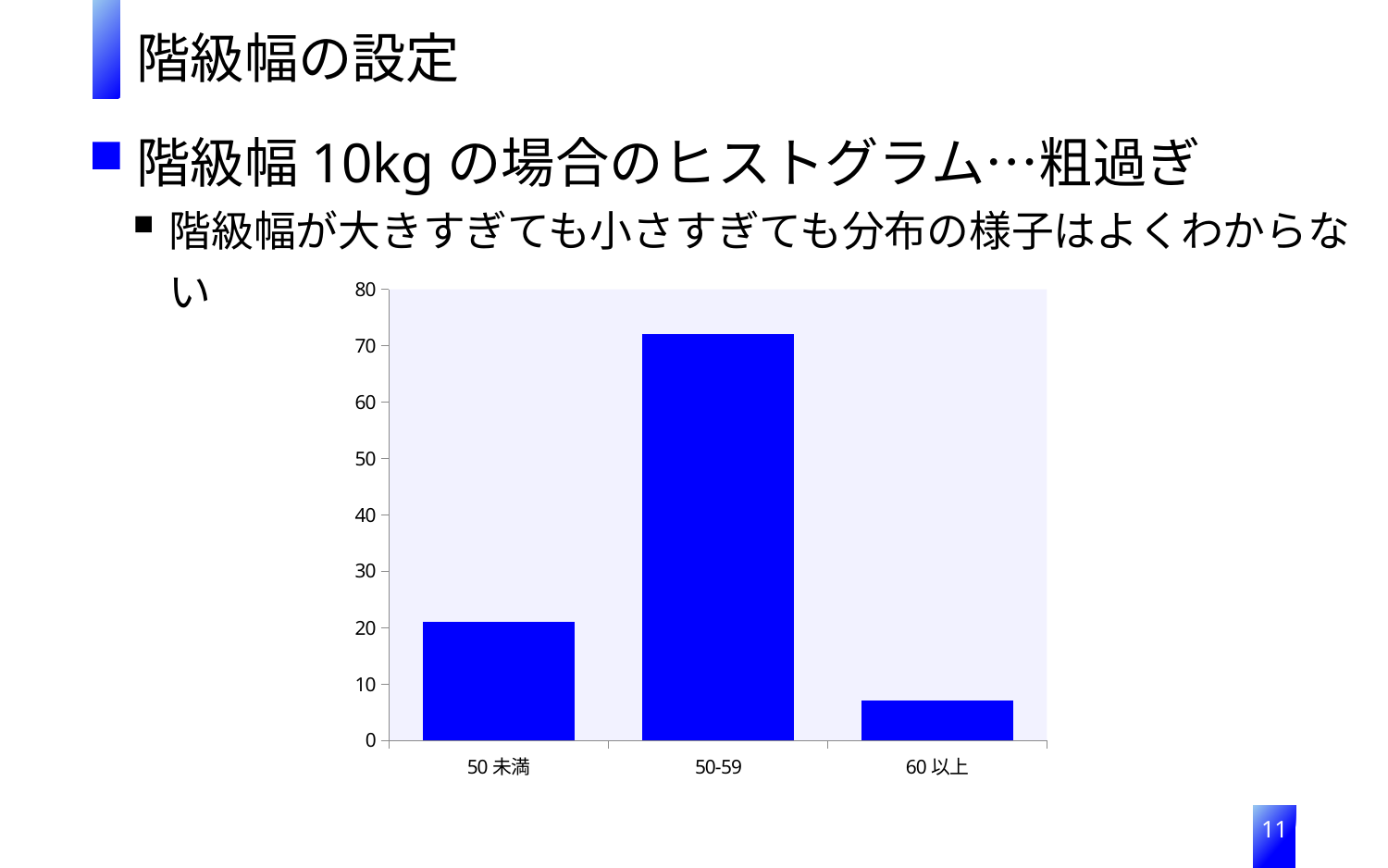
What is the maximum value shown on the y axis of the chart? 80 Is the value for 60 以上 greater or less than 10? less Which is larger, the value for 50 未満 or the value for 60 以上? 50 未満 What kind of chart is shown on the slide? bar chart What colour are the bars in the chart? blue Which category has the highest bar in the chart? 50-59 Is the value for 50 未満 greater or less than 30? less Which is larger, the value for 50-59 or the value for 50 未満? 50-59 Is the value for 50-59 greater or less than 70? greater Which category has the lowest bar in the chart? 60 以上 How many categories are shown on the x axis of the chart? 3